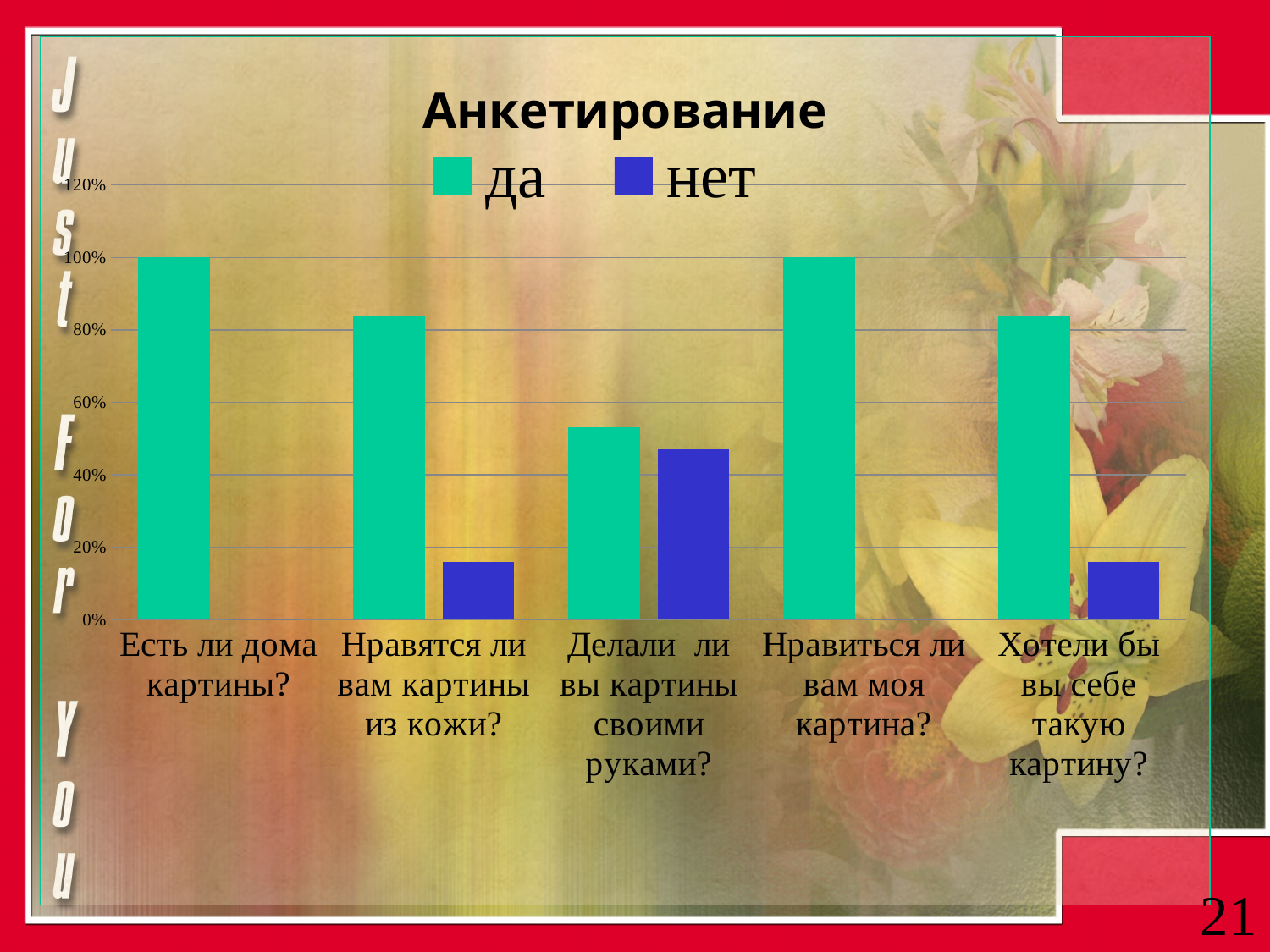
For which question is the "да" value the lowest? Делали ли вы картины своими руками? How many series does the legend list? 2 What is the value of "да" for "Есть ли дома картины?"? 100% What is the value of "да" for "Нравиться ли вам моя картина?"? 100% Is the value of "да" for "Нравятся ли вам картины из кожи?" greater or less than 80%? greater Is the value of "нет" for "Хотели бы вы себе такую картину?" greater or less than 20%? less Is the value of "нет" for "Делали ли вы картины своими руками?" greater or less than 40%? greater What type of chart is shown on the slide? bar chart For which question is the "нет" value the highest? Делали ли вы картины своими руками? How many question categories are shown on the x axis? 5 Which series is shown in green in the legend? да What is the title of the chart? Анкетирование